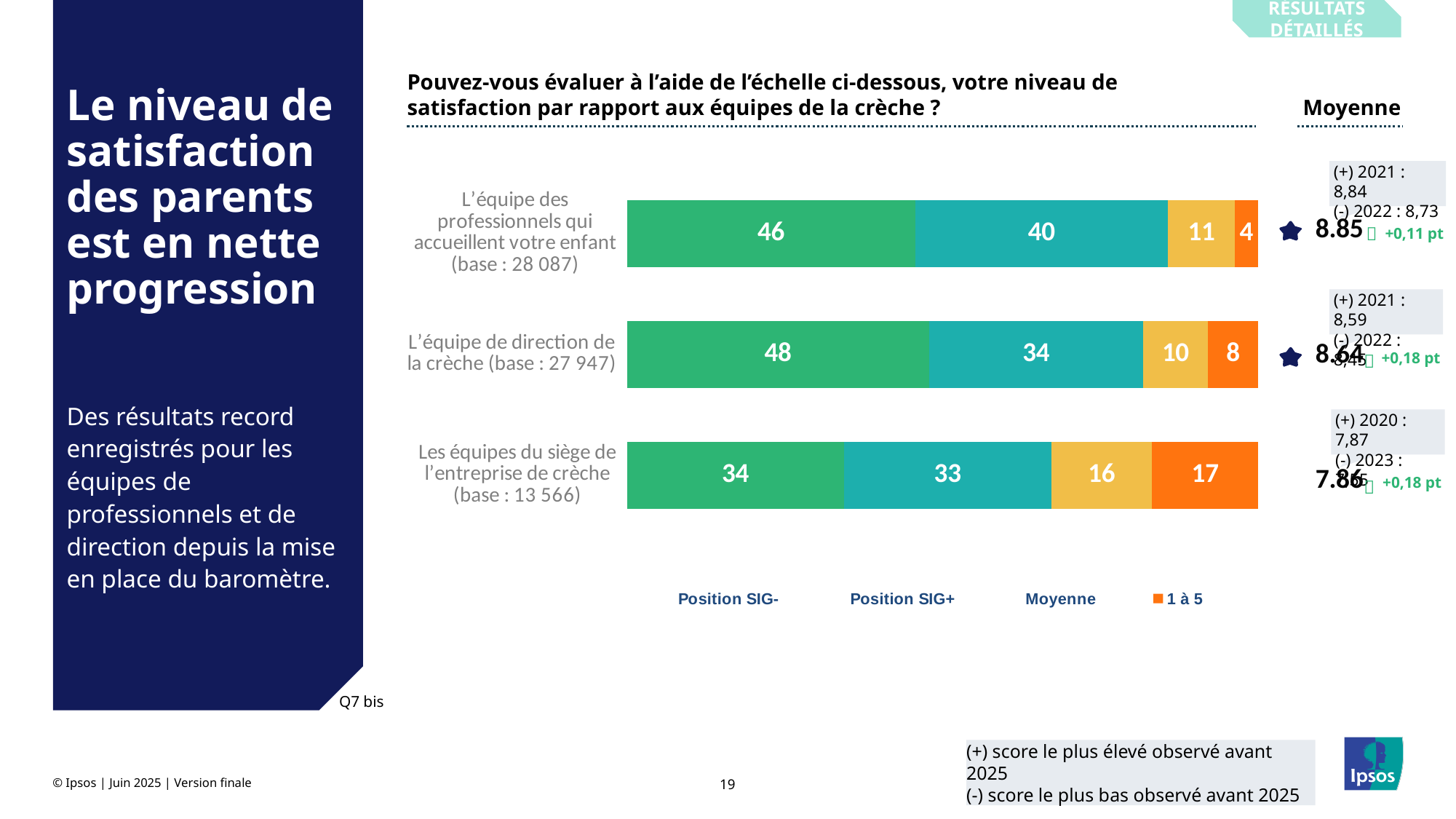
What is the base (number of respondents) shown for 'Les équipes du siège de l'entreprise de crèche'? 13 566 Which has the larger teal (second) segment: 'L'équipe des professionnels qui accueillent votre enfant' or 'L'équipe de direction de la crèche'? L'équipe des professionnels qui accueillent votre enfant What is the difference between the green segment values of 'L'équipe de direction de la crèche' and 'Les équipes du siège de l'entreprise de crèche'? 14 How many categories (teams) are plotted in the chart? 3 How many series does the chart legend list? 4 What is the total of the stacked bar for 'L'équipe de direction de la crèche'? 100 Which category has the highest value in the green (first) segment? L'équipe de direction de la crèche Which category has the lowest value in the orange '1 à 5' segment? L'équipe des professionnels qui accueillent votre enfant What kind of chart is shown on the slide? Stacked bar chart What is the value of the green segment for 'L'équipe des professionnels qui accueillent votre enfant'? 46 What is the value of the orange '1 à 5' segment for 'Les équipes du siège de l'entreprise de crèche'? 17 What is the 'Moyenne' score shown for 'L'équipe de direction de la crèche'? 8.64